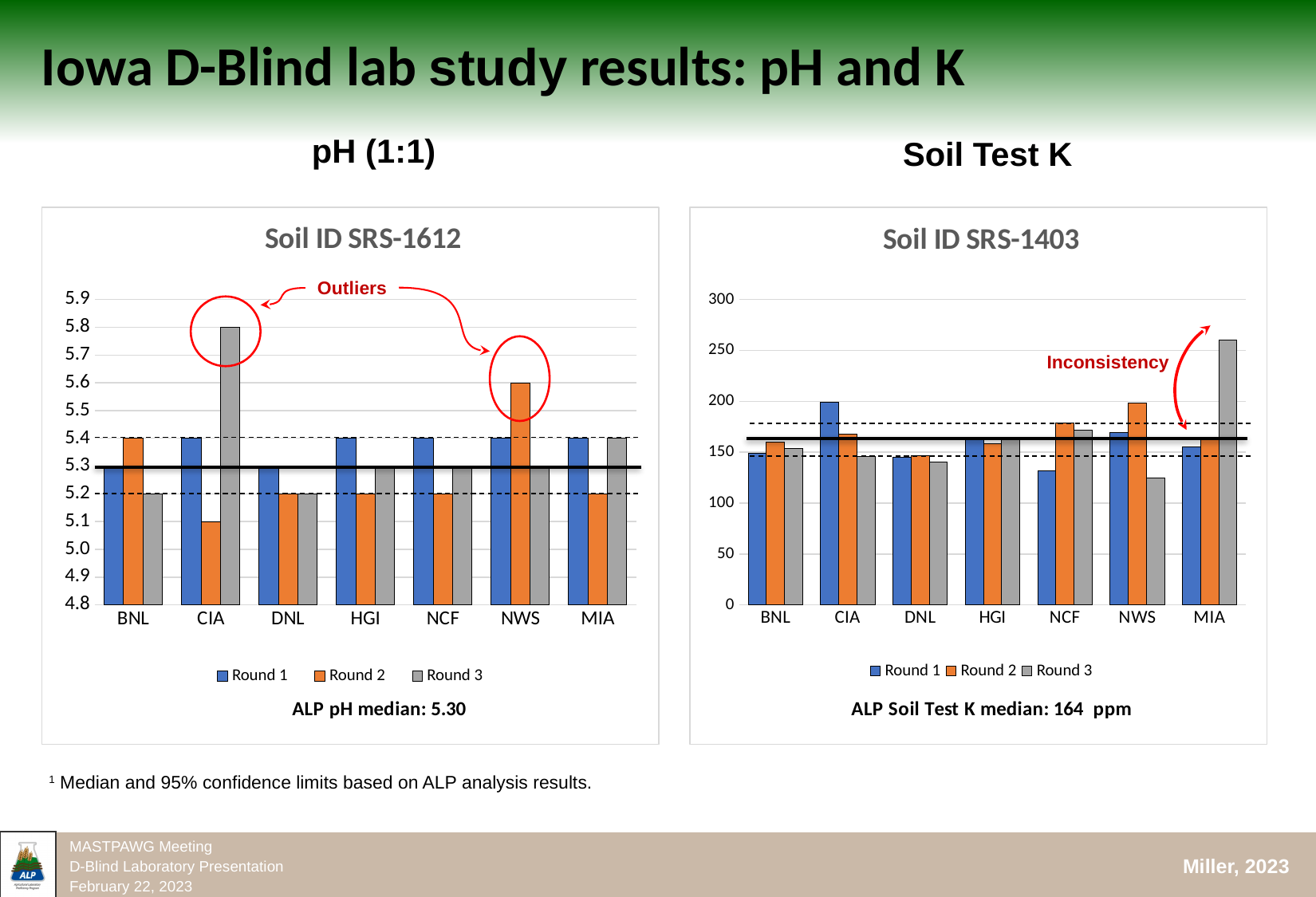
How many labs are shown on the x axis of the Soil Test K chart? 7 On the pH (1:1) chart, what is the difference between the Round 3 and Round 2 values for CIA? 0.7 On the pH (1:1) chart, what is the Round 2 value for NWS? 5.6 On the pH (1:1) chart, which lab and round has the lowest pH value? CIA, Round 2 On the pH (1:1) chart, what is the Round 2 value for CIA? 5.1 On the Soil Test K chart, is the Round 3 value for NWS greater or less than 150? less On the Soil Test K chart, which is larger: the Round 1 value for CIA or the Round 1 value for DNL? Round 1 value for CIA On the pH (1:1) chart, which lab and round has the highest pH value? CIA, Round 3 On the Soil Test K chart, which lab and round has the highest value? MIA, Round 3 On the Soil Test K chart, is the Round 3 value for MIA greater or less than 250? greater How many series does the legend of the pH (1:1) chart list? 3 On the pH (1:1) chart, what is the Round 3 value for CIA? 5.8